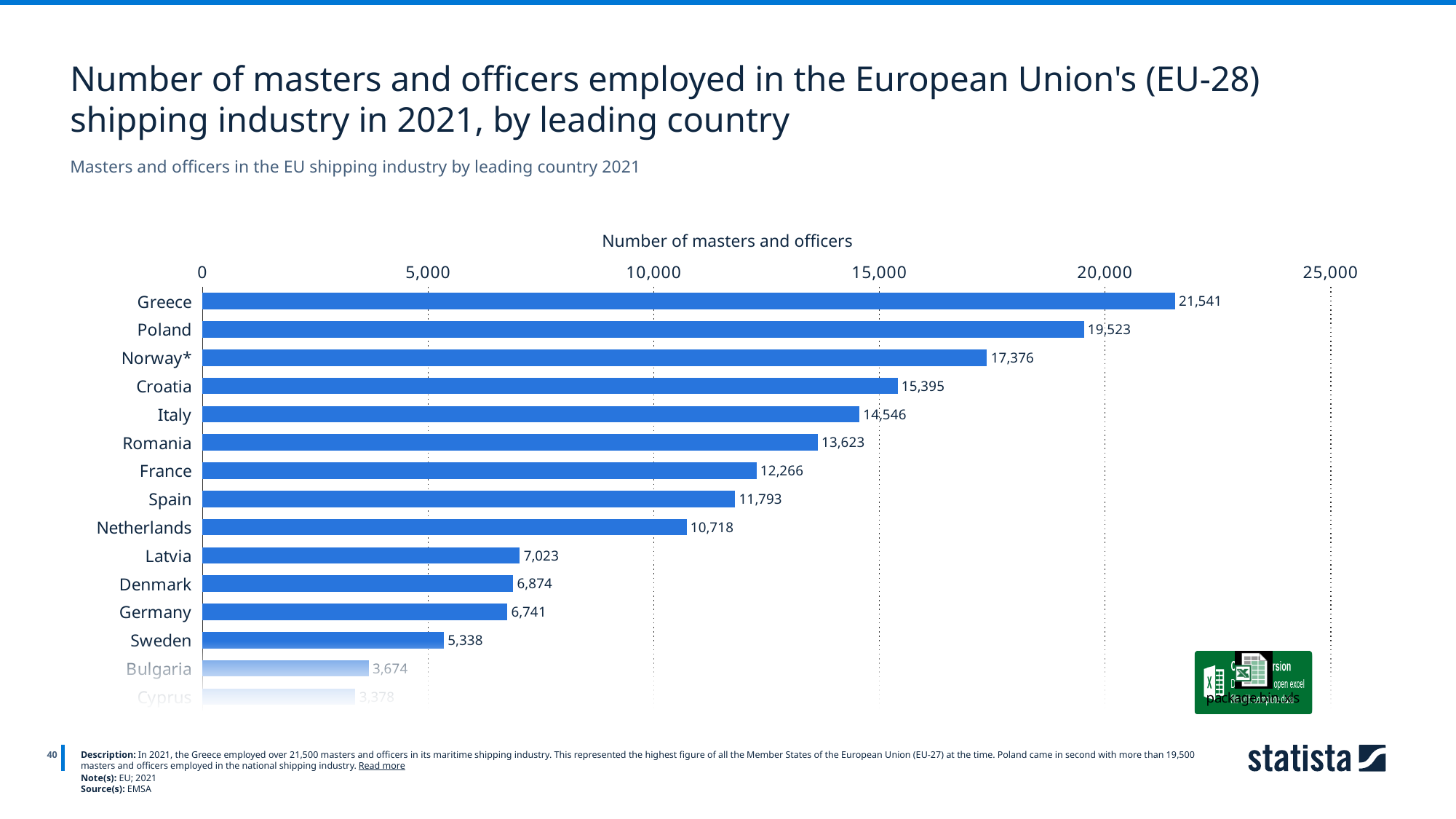
What is the difference between the values for Italy and Romania? 923 How many countries are shown on the chart? 15 Which country has the lowest number of masters and officers on the chart? Cyprus Is the value for Croatia greater or less than 15,000? greater Which country has the highest number of masters and officers? Greece What is the value shown for the Netherlands? 10,718 Which has a larger value, France or Spain? France What type of chart is shown on the slide? Bar chart What is the title of the horizontal axis? Number of masters and officers What is the difference between the values for Greece and Poland? 2,018 How many masters and officers were employed in Greece's shipping industry in 2021? 21,541 What is the value shown for Romania? 13,623